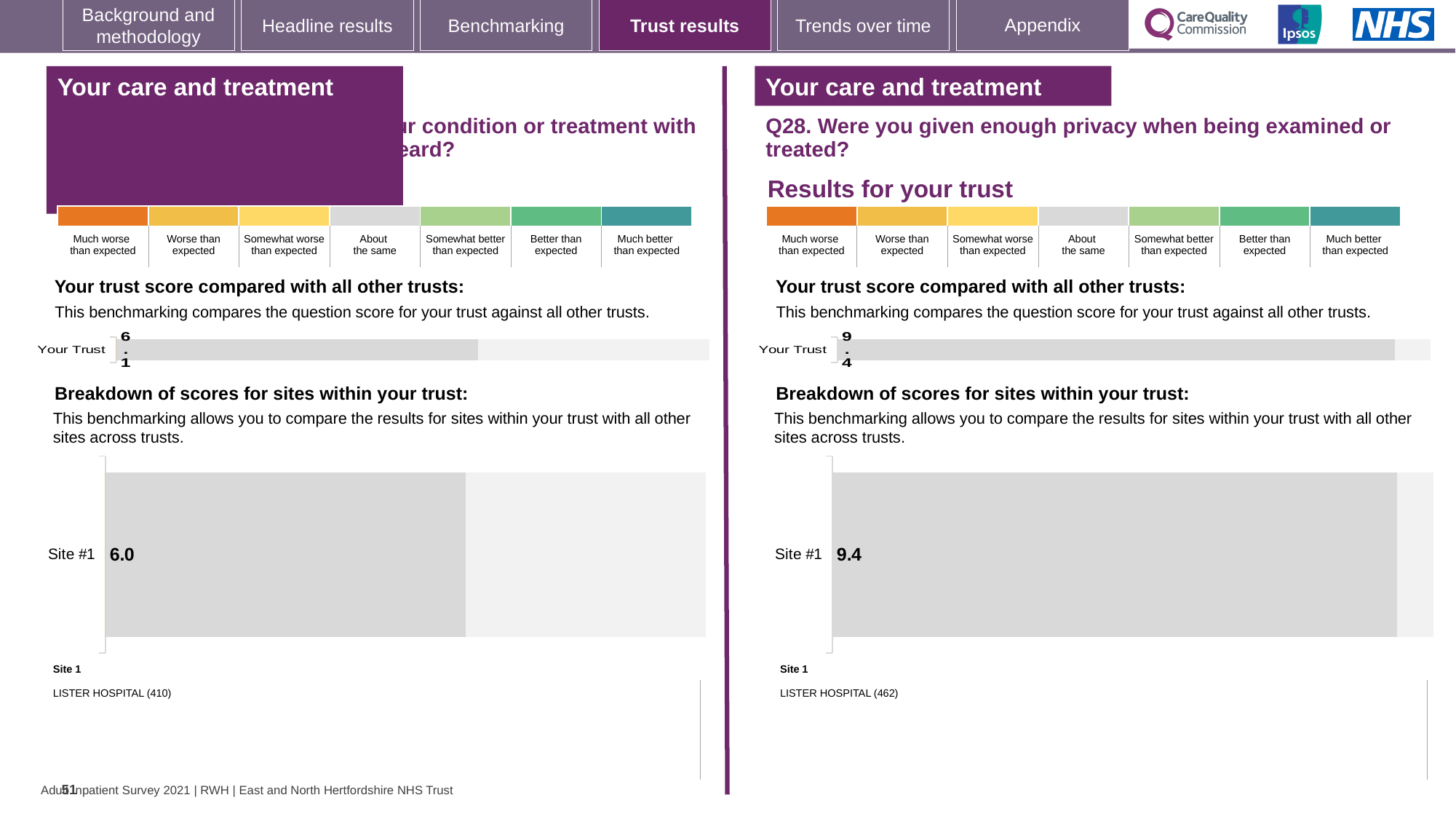
What is the difference between the Site #1 score on the right-hand panel (Q28) and the Site #1 score on the left-hand panel? 3.4 On the right-hand panel (Q28), what is the score shown for Site #1 in the 'Breakdown of scores for sites within your trust' chart? 9.4 What kind of chart is used in the 'Breakdown of scores for sites within your trust' section on the right-hand panel (Q28)? Bar chart On the left-hand panel, which site name is listed as Site 1 below the breakdown chart? LISTER HOSPITAL (410) On the left-hand panel, what is the score shown for Site #1 in the 'Breakdown of scores for sites within your trust' chart? 6.0 How many sites are plotted in the 'Breakdown of scores for sites within your trust' chart on the right-hand panel (Q28)? 1 On the right-hand panel (Q28), what is the score shown for Your Trust in the 'Your trust score compared with all other trusts' chart? 9.4 What is the difference between the Your Trust score on the right-hand panel (Q28) and the Your Trust score on the left-hand panel? 3.3 On the right-hand panel (Q28), which site name is listed as Site 1 below the breakdown chart? LISTER HOSPITAL (462) On the left-hand panel, is the Your Trust score greater or less than the Site #1 score? greater On the left-hand panel, what is the score shown for Your Trust in the 'Your trust score compared with all other trusts' chart? 6.1 Which is larger: the Site #1 score on the left-hand panel or the Site #1 score on the right-hand panel (Q28)? Right-hand panel (Q28)